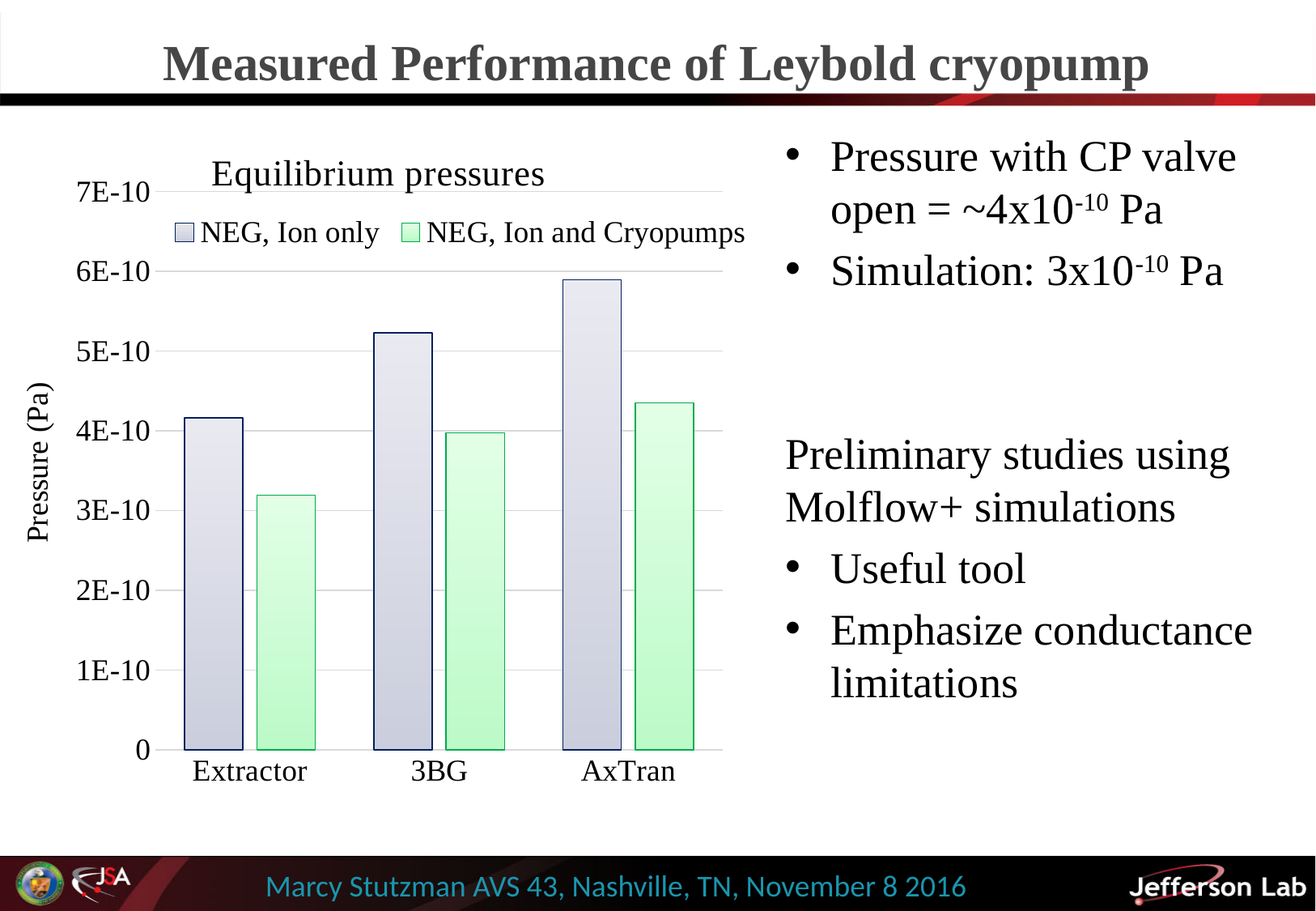
Which category has the lowest value for the NEG, Ion only series? Extractor Is the NEG, Ion and Cryopumps value for Extractor greater or less than 3E-10? greater Which is larger for 3BG: the NEG, Ion only value or the NEG, Ion and Cryopumps value? NEG, Ion only Which category has the highest value for the NEG, Ion only series? AxTran How many series does the chart legend list? 2 What is the title of the chart? Equilibrium pressures How many categories are shown on the x axis of the chart? 3 Which category has the lowest value for the NEG, Ion and Cryopumps series? Extractor What type of chart is shown on the slide? bar chart Do the NEG, Ion only values rise or fall from Extractor to AxTran along the x axis? rise Is the NEG, Ion only value for AxTran greater or less than 5E-10? greater Is the NEG, Ion and Cryopumps value for AxTran greater or less than 5E-10? less